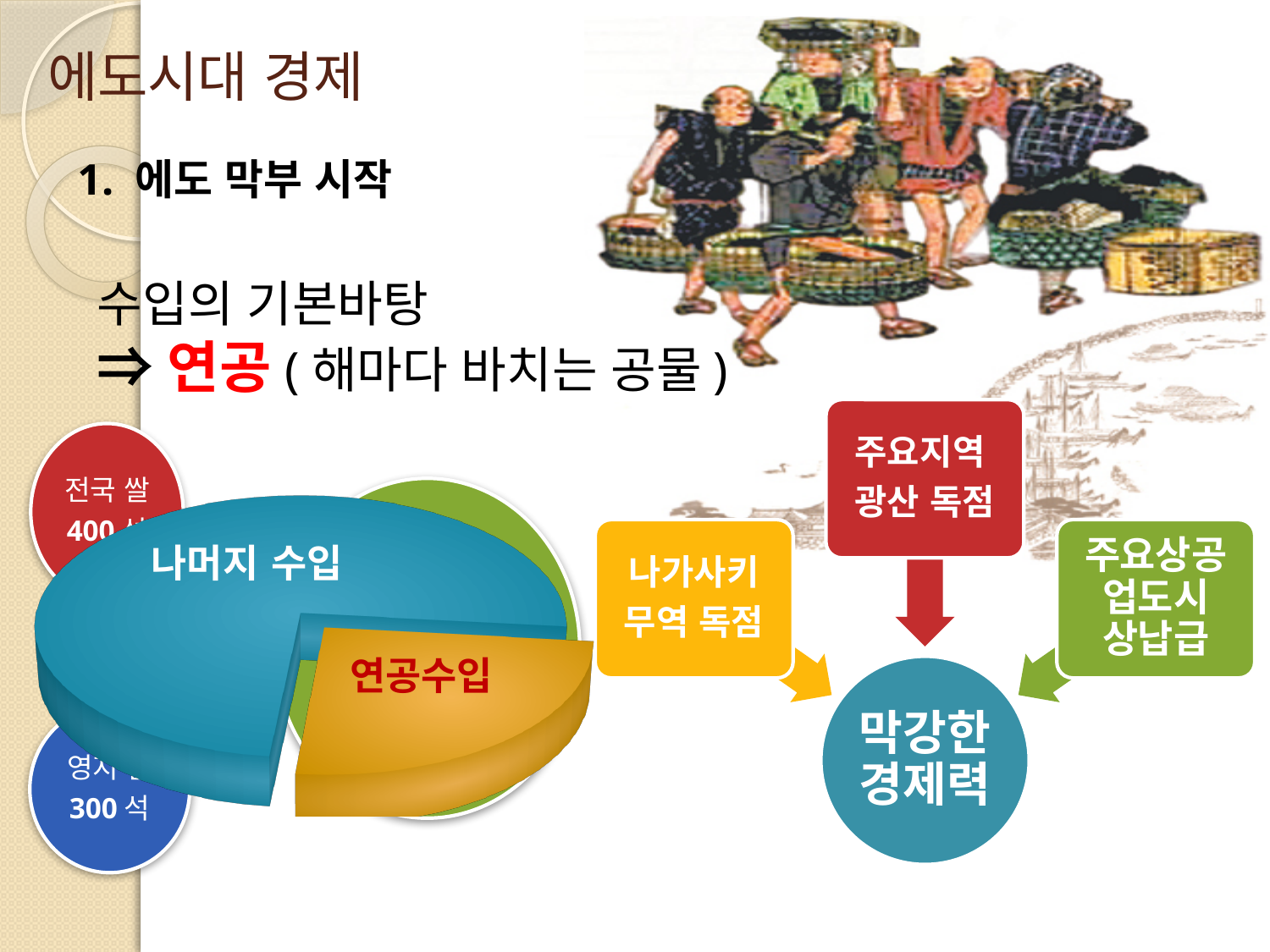
What colour is the 연공수입 slice of the pie chart? orange Which slice of the pie chart is the largest? 나머지 수입 Which slice of the pie chart is pulled out (exploded) from the rest of the pie? 연공수입 What kind of chart is shown on the slide? pie chart How many slices does the pie chart have? 2 Which slice of the pie chart is the smallest? 연공수입 Which slice of the pie chart is larger, 나머지 수입 or 연공수입? 나머지 수입